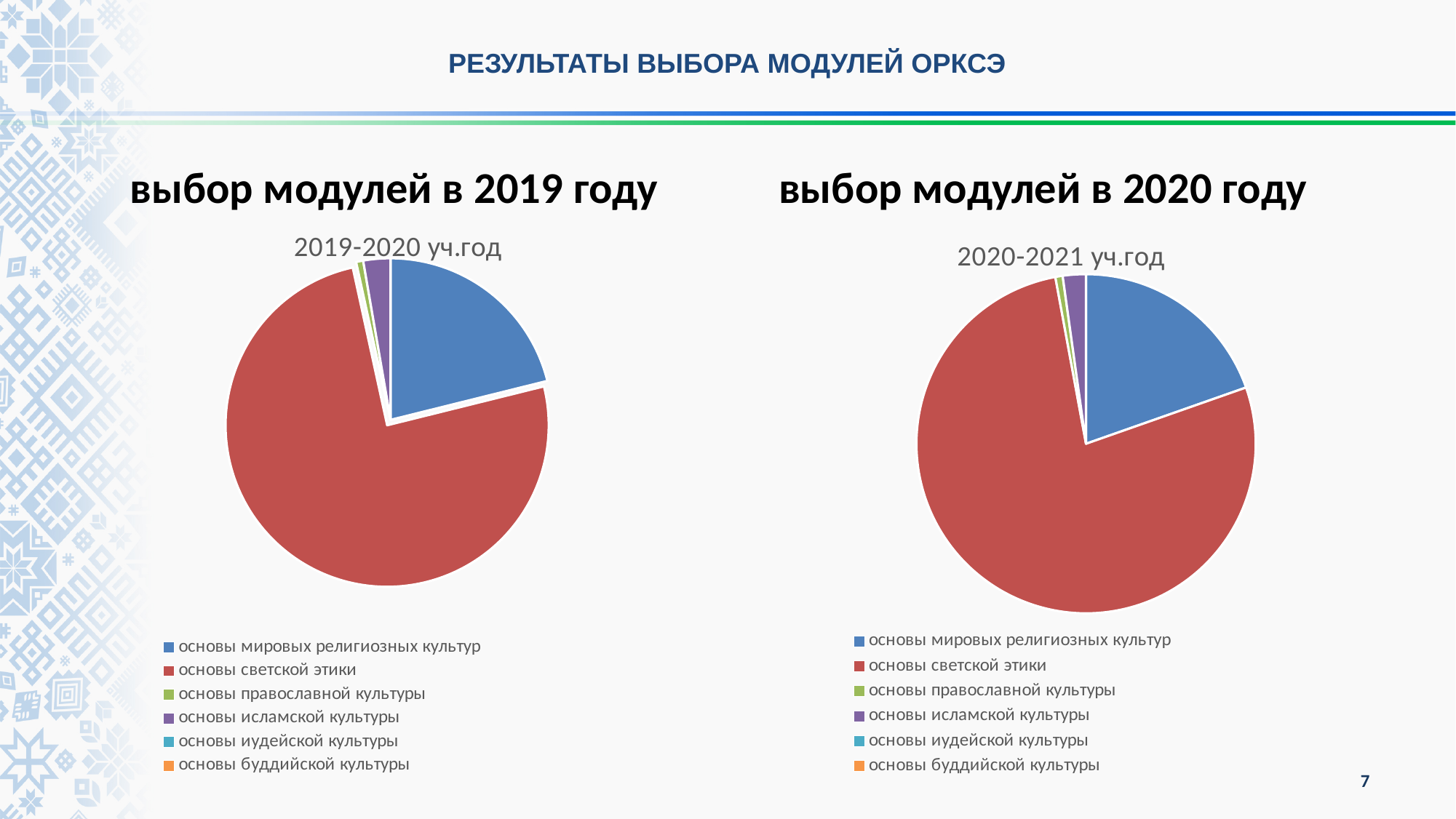
What is the title of the pie chart on the left side of the slide? 2019-2020 уч.год How many entries does the legend of the right chart (2020-2021 уч.год) list? 6 How many entries does the legend of the left chart (2019-2020 уч.год) list? 6 In the left chart (2019-2020 уч.год), which slice is larger: основы православной культуры or основы светской этики? основы светской этики In the right chart (2020-2021 уч.год), which slice is larger: основы исламской культуры or основы православной культуры? основы исламской культуры What type of chart is shown under the heading "выбор модулей в 2020 году"? pie chart In the left chart (2019-2020 уч.год), which module has the largest slice? основы светской этики What type of chart is shown under the heading "выбор модулей в 2019 году"? pie chart In the right chart (2020-2021 уч.год), which slice is larger: основы светской этики or основы мировых религиозных культур? основы светской этики In the right chart (2020-2021 уч.год), which module has the largest slice? основы светской этики In the right chart (2020-2021 уч.год), what colour is the slice for основы мировых религиозных культур? blue